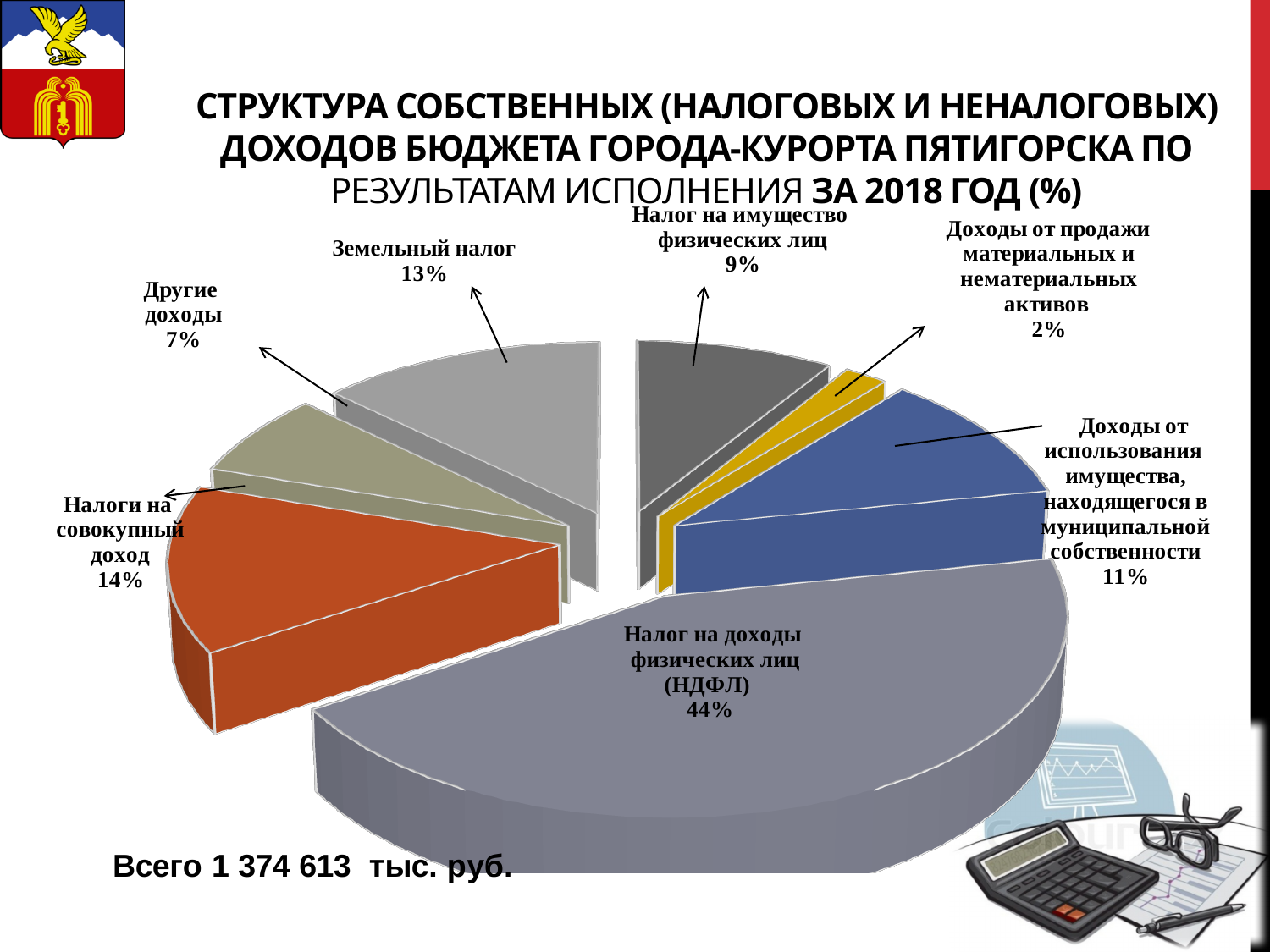
Which category has the smallest slice of the pie? Доходы от продажи материальных и нематериальных активов What is the value shown for "Земельный налог"? 13% What type of chart is shown on the slide? Pie chart How many categories (slices) does the pie chart have? 7 Which year does the chart title say the data refers to? 2018 Which is larger: the share of "Доходы от использования имущества, находящегося в муниципальной собственности" or the share of "Налог на имущество физических лиц"? Доходы от использования имущества, находящегося в муниципальной собственности What is the difference between the shares of "Налоги на совокупный доход" and "Другие доходы"? 7% What total amount is stated below the chart? 1 374 613 тыс. руб. Which category has the largest slice of the pie? Налог на доходы физических лиц (НДФЛ) What share of the pie does "Налог на доходы физических лиц (НДФЛ)" have? 44% What is the value shown for "Налоги на совокупный доход"? 14% What is the value shown for "Доходы от продажи материальных и нематериальных активов"? 2%